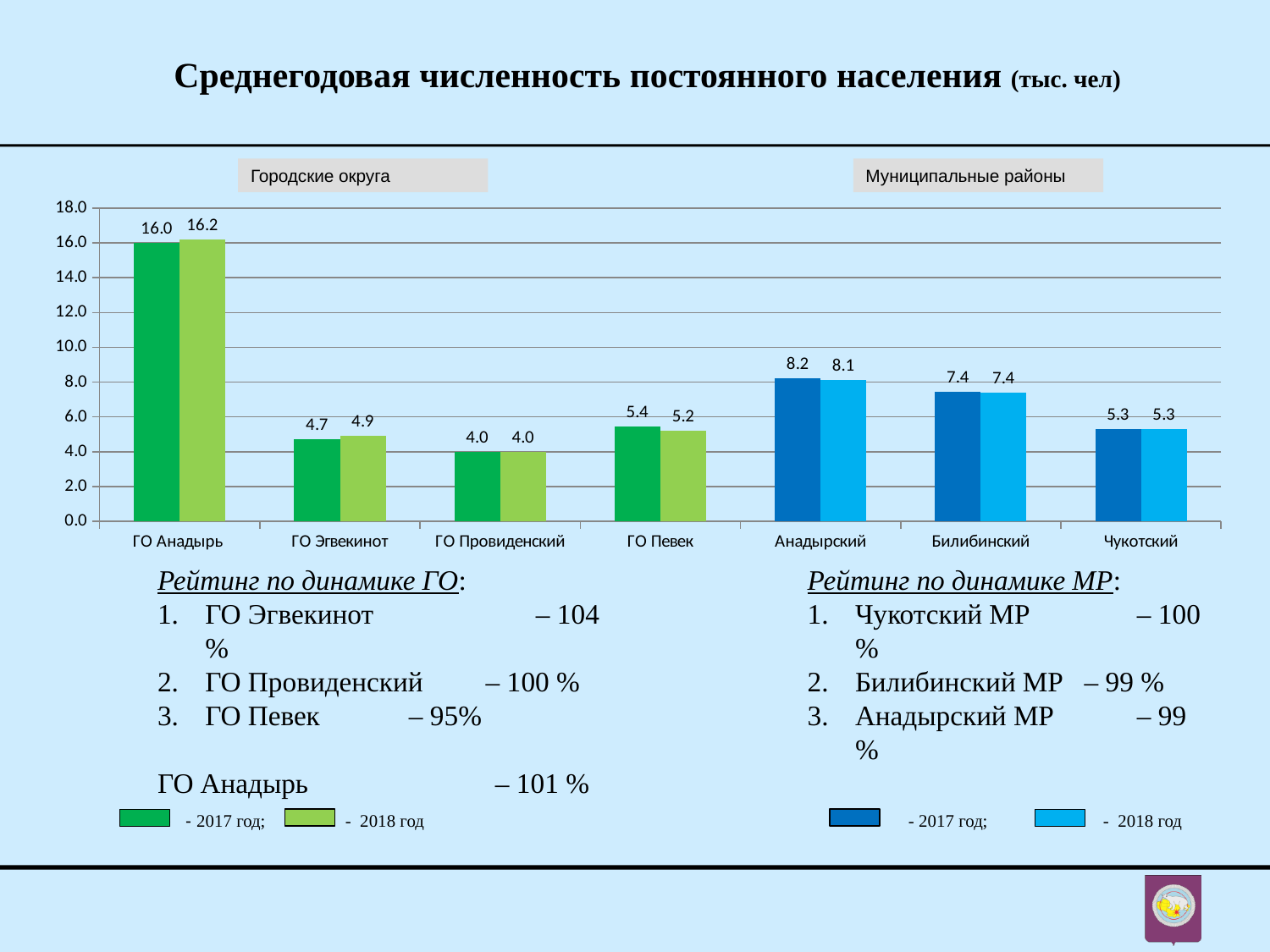
What is the 2018 value for ГО Эгвекинот? 4.9 What kind of chart is shown on the slide? bar chart What is the 2017 value for ГО Анадырь? 16.0 How many categories are shown on the x axis? 7 What is the difference between the 2018 and 2017 values for ГО Анадырь? 0.2 Which is larger: the 2017 value for ГО Певек or the 2017 value for Чукотский? ГО Певек What is the 2018 value for Чукотский? 5.3 Which category has the lowest 2017 value? ГО Провиденский Which category has the highest 2018 value? ГО Анадырь Is the 2017 value for Билибинский greater or less than 8.0? less What is the 2017 value for Анадырский? 8.2 Which two years does the legend list for each group of bars? 2017 and 2018